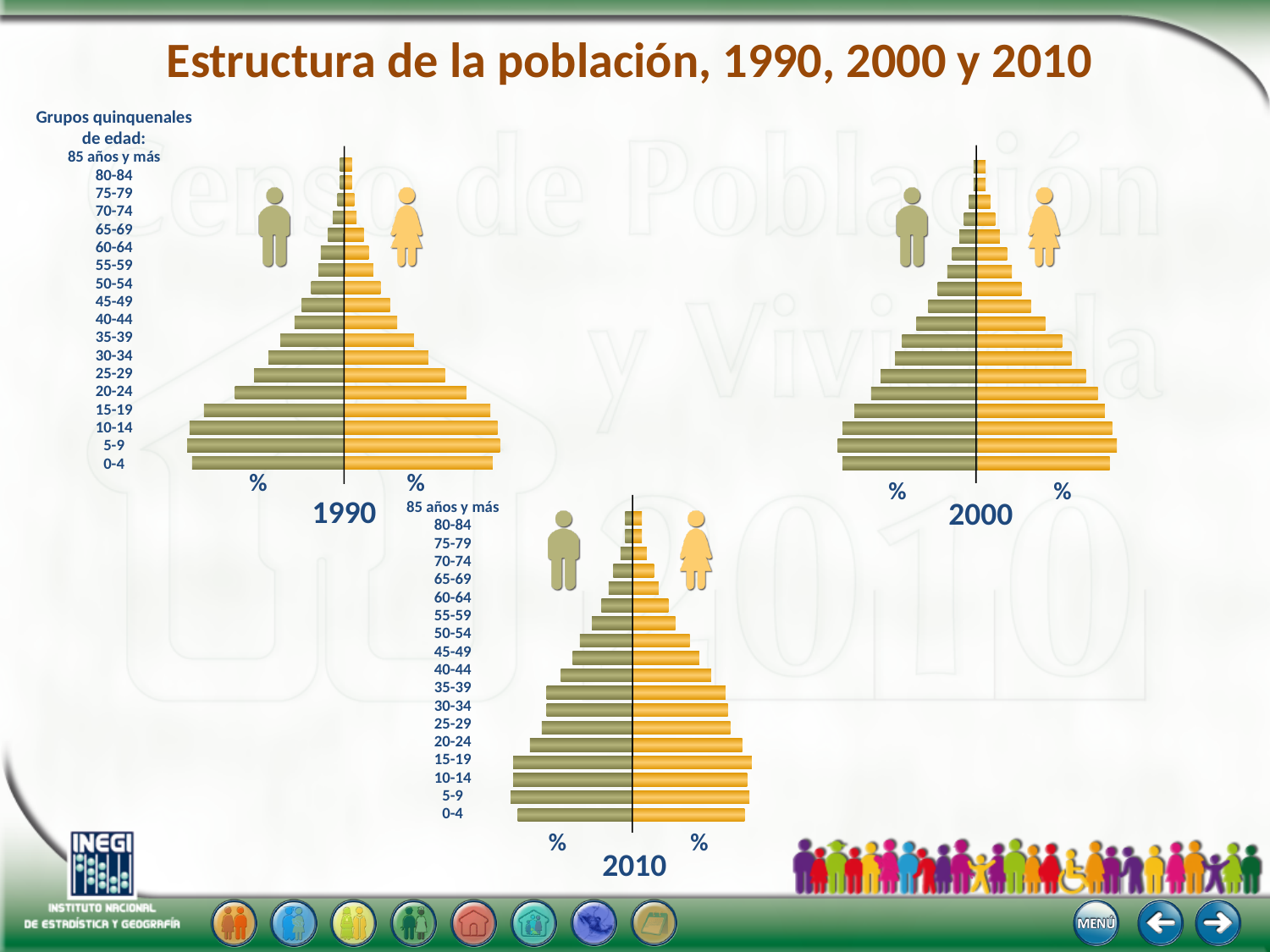
In the 1990 pyramid, which age group has the widest bars? 5-9 In the 2010 pyramid, which is larger, the bar for 15-19 or the bar for 75-79? 15-19 What is the title of the slide? Estructura de la población, 1990, 2000 y 2010 In the 2010 pyramid, which is larger, the bar for 0-4 or the bar for 60-64? 0-4 Comparing the 1990 and 2010 pyramids, which year has the wider bar for the 0-4 age group? 1990 In the 1990 pyramid, do the bars get wider or narrower as the age group increases from 0-4 to 85 años y más? Narrower How many charts are shown on the slide? 3 What kind of chart is used for each of the three years on the slide? Bar chart (population pyramid) How many five-year age groups are listed on the vertical axis of each pyramid? 18